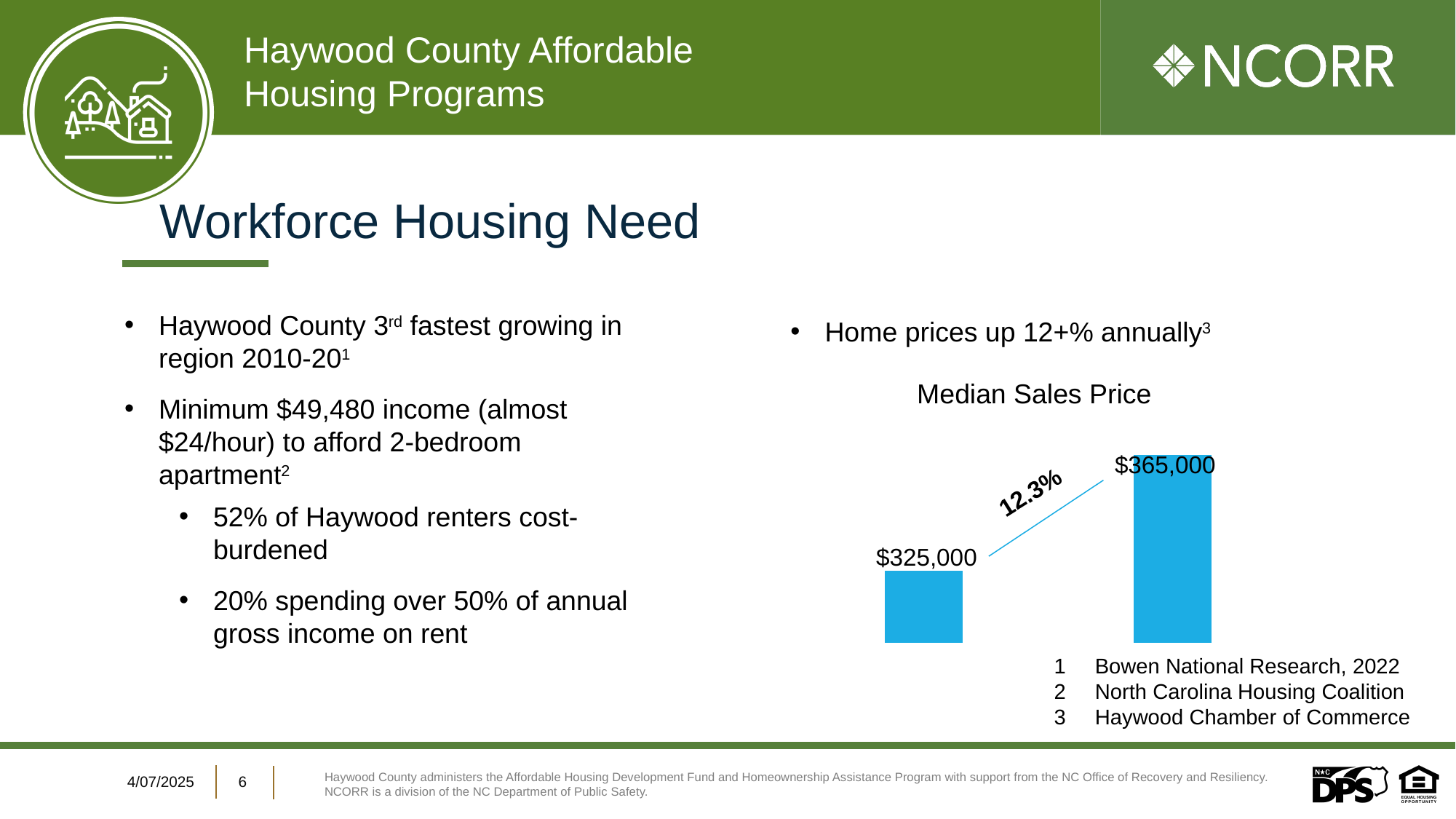
What percentage change is annotated between the two bars in the Median Sales Price chart? 12.3% What is the title of the chart on the right side of the slide? Median Sales Price What kind of chart is shown under the heading "Median Sales Price"? bar chart In the Median Sales Price chart, which bar is taller, the left or the right? right How many bars are plotted in the Median Sales Price chart? 2 In the Median Sales Price chart, which bar has the lowest value? the left bar ($325,000) In the Median Sales Price chart, what is the difference between the right bar and the left bar? $40,000 In the Median Sales Price chart, what value is labelled on the left bar? $325,000 In the Median Sales Price chart, what value is labelled on the right bar? $365,000 Do the values in the Median Sales Price chart rise or fall from left to right? rise